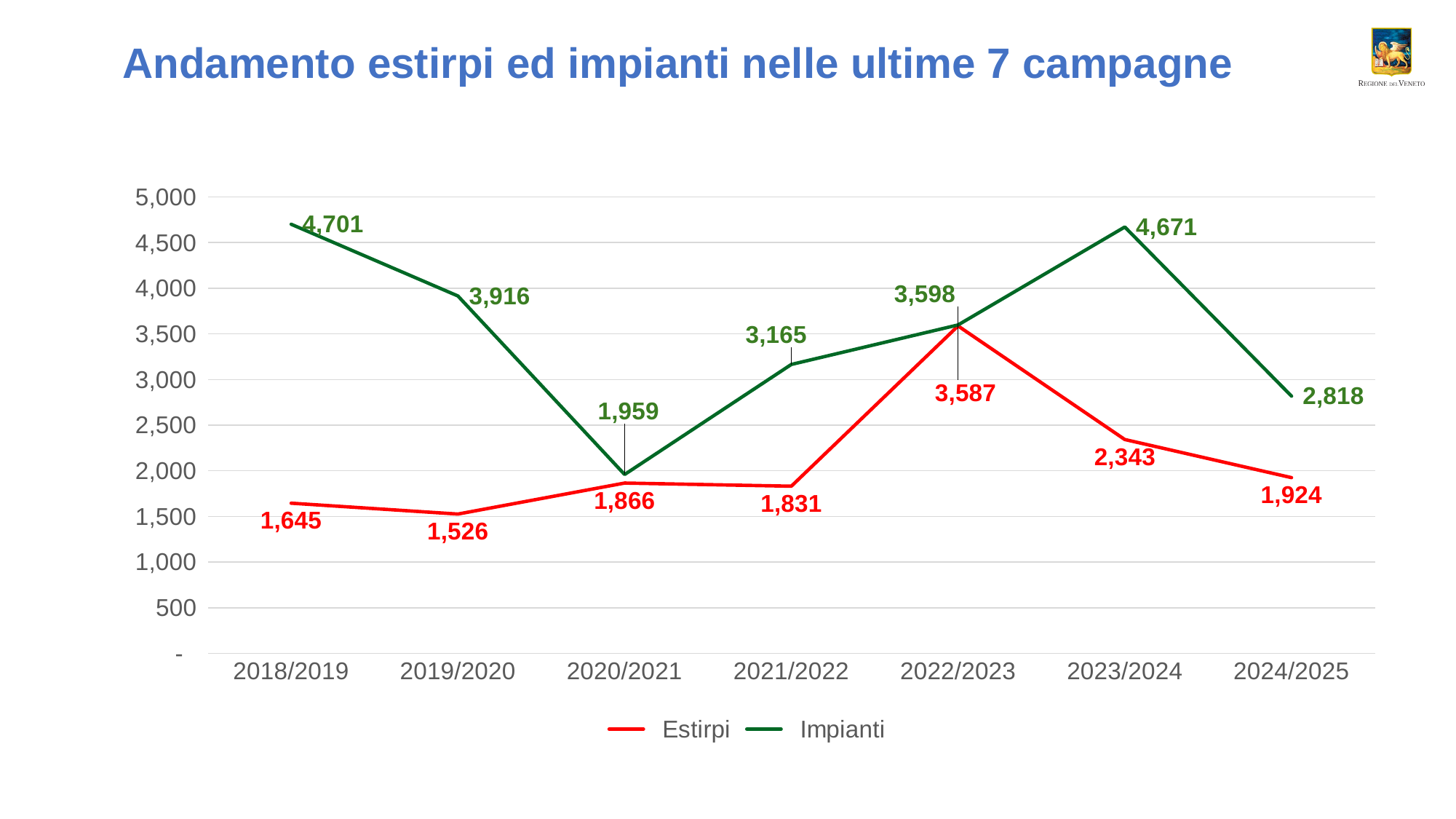
How many campaigns are shown on the x axis? 7 How many series does the legend list? 2 In which campaign is Impianti at its highest? 2018/2019 What kind of chart is shown on the slide? Line chart Which is larger in 2020/2021, Estirpi or Impianti? Impianti In which campaign is Estirpi at its lowest? 2019/2020 Does Impianti rise or fall from 2023/2024 to 2024/2025? Fall What is the value of Impianti in 2018/2019? 4,701 What is the difference between Impianti and Estirpi in 2023/2024? 2,328 In which campaign is Impianti at its lowest? 2020/2021 What is the value of Impianti in 2024/2025? 2,818 What is the value of Estirpi in 2022/2023? 3,587